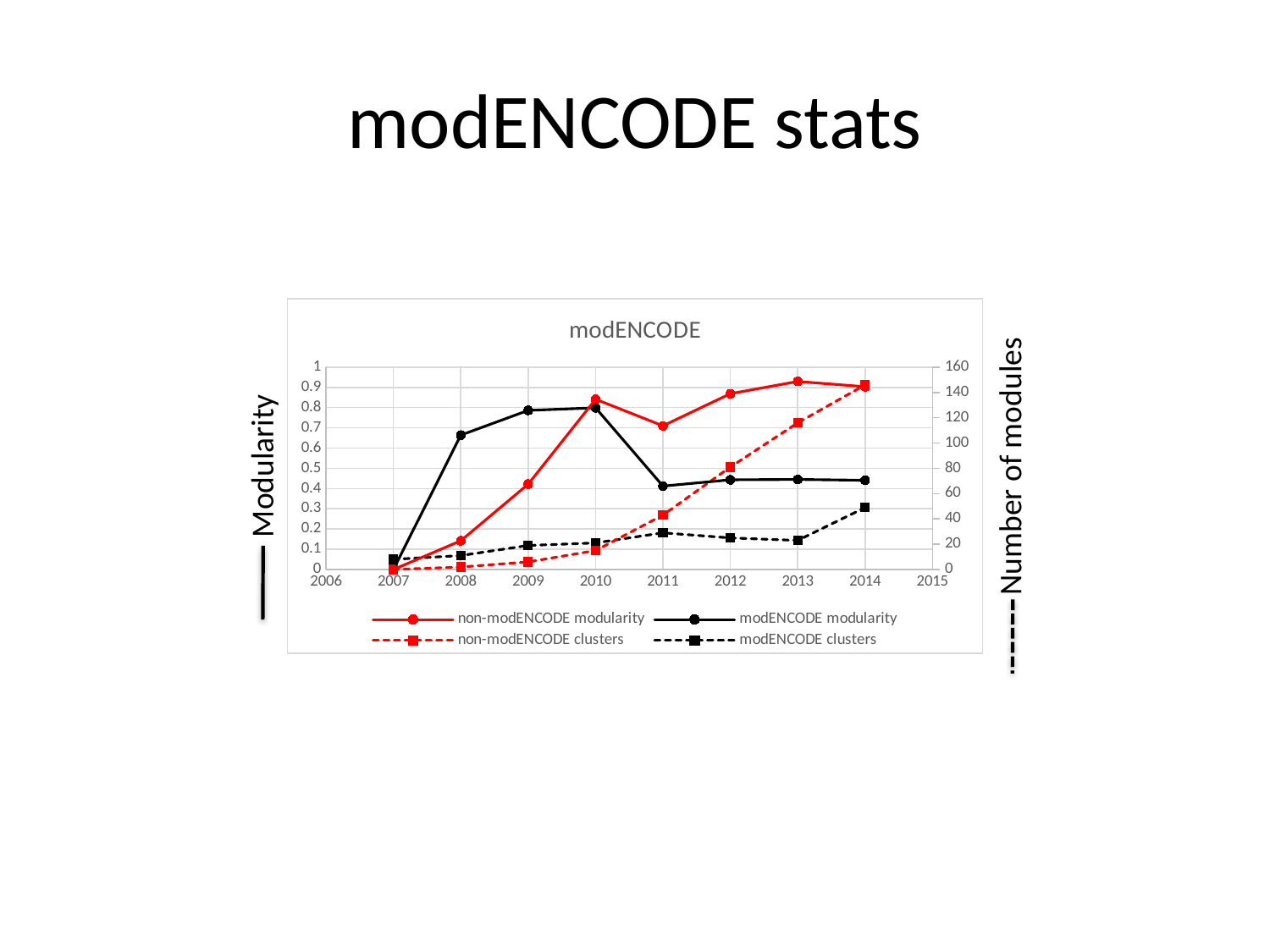
Does the non-modENCODE clusters series rise or fall from 2007 to 2014? rise How many years have data points plotted on the chart? 8 Is the modENCODE modularity value for 2011 greater or less than 0.5? less Is the non-modENCODE clusters value for 2013 greater or less than 100? greater In 2008, which series has the higher modularity, modENCODE modularity or non-modENCODE modularity? modENCODE modularity Is the non-modENCODE clusters value for 2014 greater or less than 140? greater What kind of chart is shown on the slide? line chart What is the title of the chart? modENCODE In which year is the non-modENCODE clusters value highest? 2014 What is the label of the right-hand vertical axis? Number of modules How many series does the legend list? 4